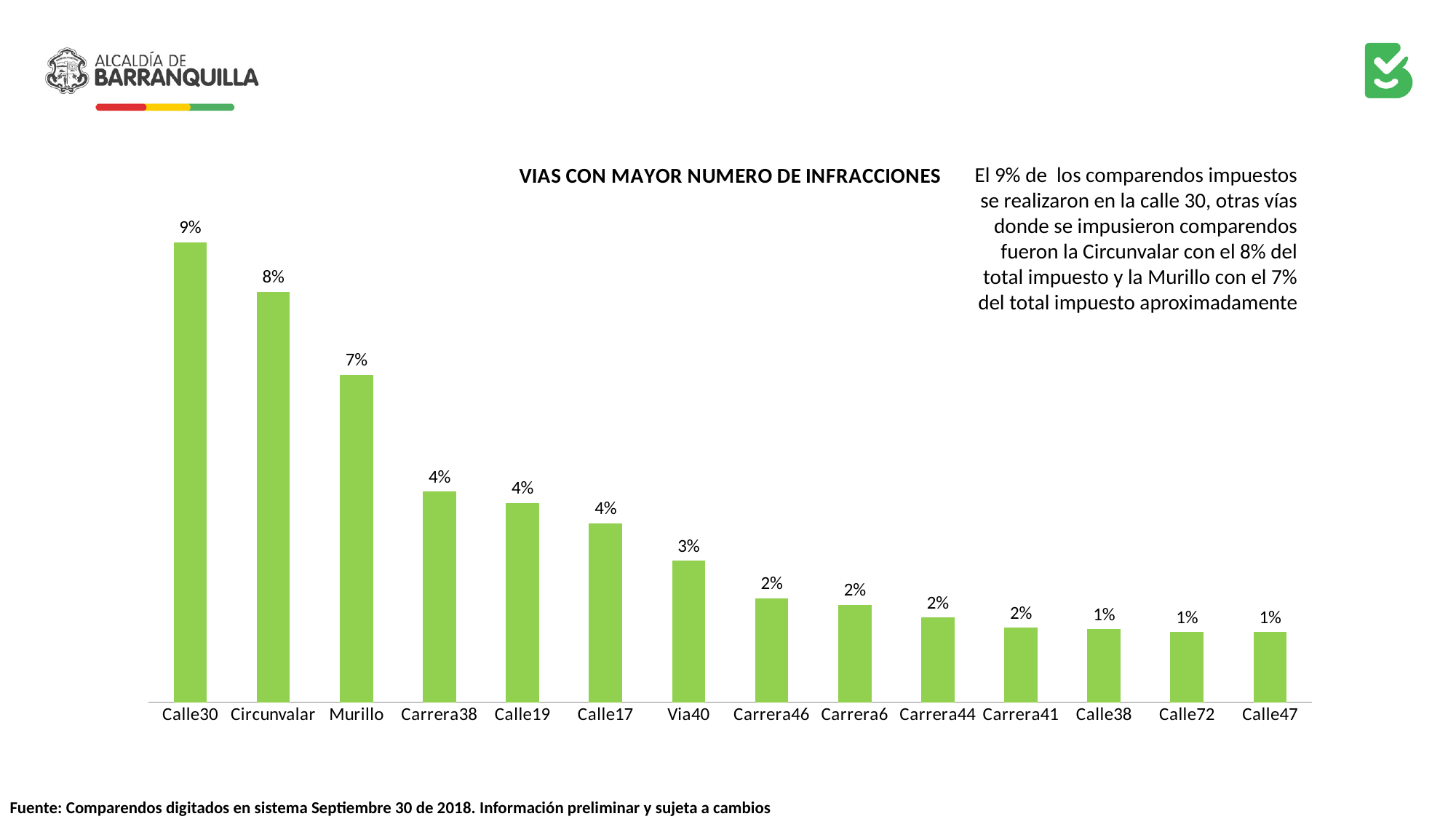
Which category has the highest value? Calle30 What is the difference between the values for Murillo and Via40? 4% What is the value for Murillo? 7% What is the value for Calle30? 9% What is the value for Via40? 3% What is the value for Carrera46? 2% What kind of chart is shown on the slide? Bar chart How many categories are shown on the x axis? 14 What is the value for Calle47? 1% Which is larger, the value for Circunvalar or the value for Carrera38? Circunvalar What is the difference between the values for Calle30 and Circunvalar? 1% What is the value for Circunvalar? 8%